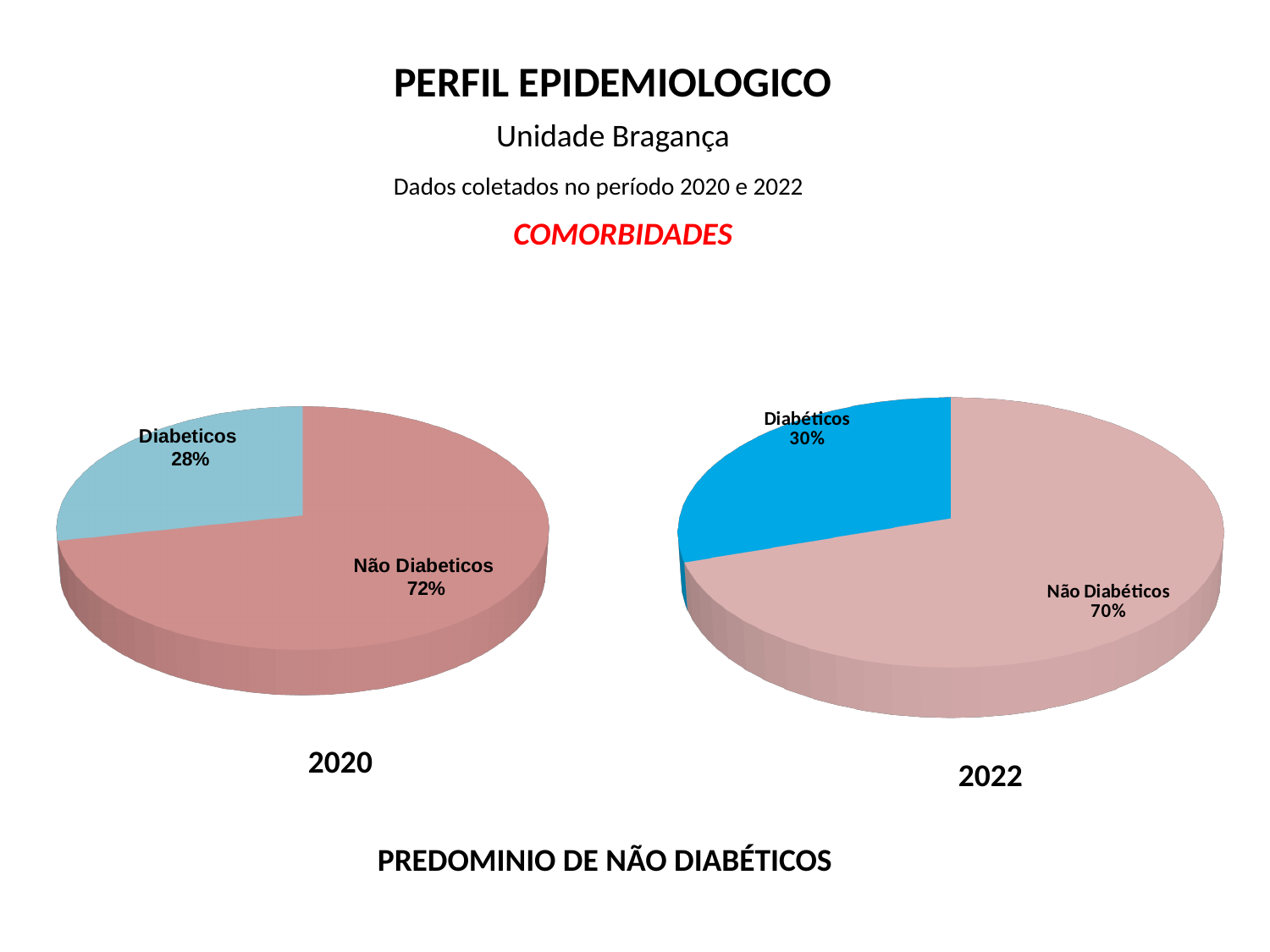
In the 2022 pie chart, which slice is the smallest? Diabéticos In the 2020 pie chart, what share is labelled for Diabeticos? 28% In the 2022 pie chart, what share is labelled for Não Diabéticos? 70% In the 2020 pie chart, what is the difference in percentage points between Não Diabeticos and Diabeticos? 44 percentage points How many pie charts are shown on the slide? 2 What colour is the Diabéticos slice in the 2022 pie chart? Blue Is the Diabéticos share larger in the 2020 chart or the 2022 chart? 2022 In the 2020 pie chart, what share is labelled for Não Diabeticos? 72% How many slices does the 2020 pie chart have? 2 In the 2020 pie chart, which slice is the largest? Não Diabeticos In the 2022 pie chart, what share is labelled for Diabéticos? 30% What kind of chart is used for the 2022 data? Pie chart